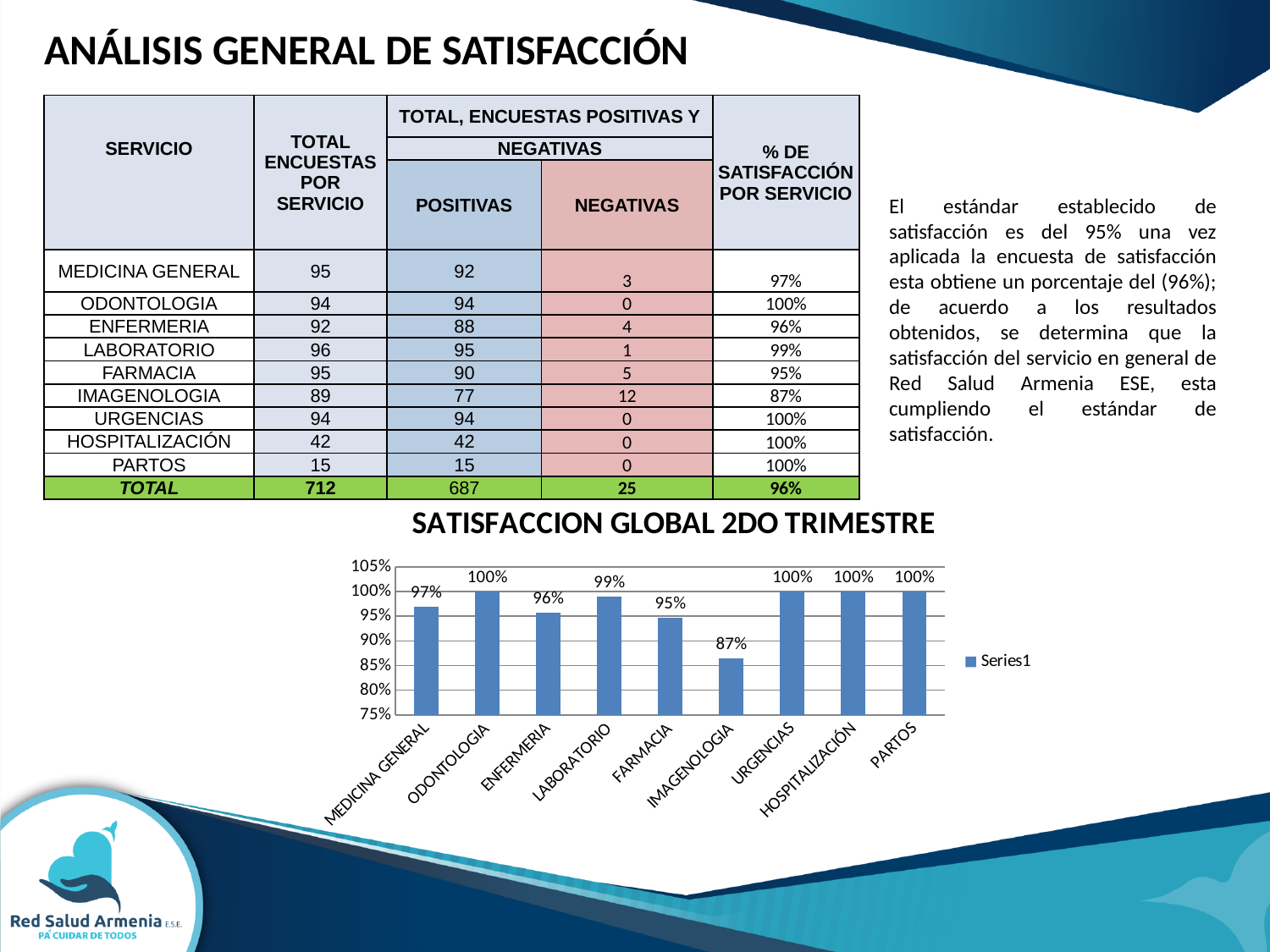
What is the value for IMAGENOLOGIA in the chart? 87% Which category has the lowest value in the chart? IMAGENOLOGIA How many categories are shown on the x axis of the chart? 9 Which is larger, the value for ENFERMERIA or the value for FARMACIA? ENFERMERIA What is the title of the chart? SATISFACCION GLOBAL 2DO TRIMESTRE What is the value for MEDICINA GENERAL in the chart? 97% How many series does the chart legend list? 1 What kind of chart is shown on the slide? bar chart Is the value for IMAGENOLOGIA greater or less than 90%? less What is the value for LABORATORIO in the chart? 99% What is the difference between the values for LABORATORIO and FARMACIA? 4% What is the name of the series listed in the chart legend? Series1